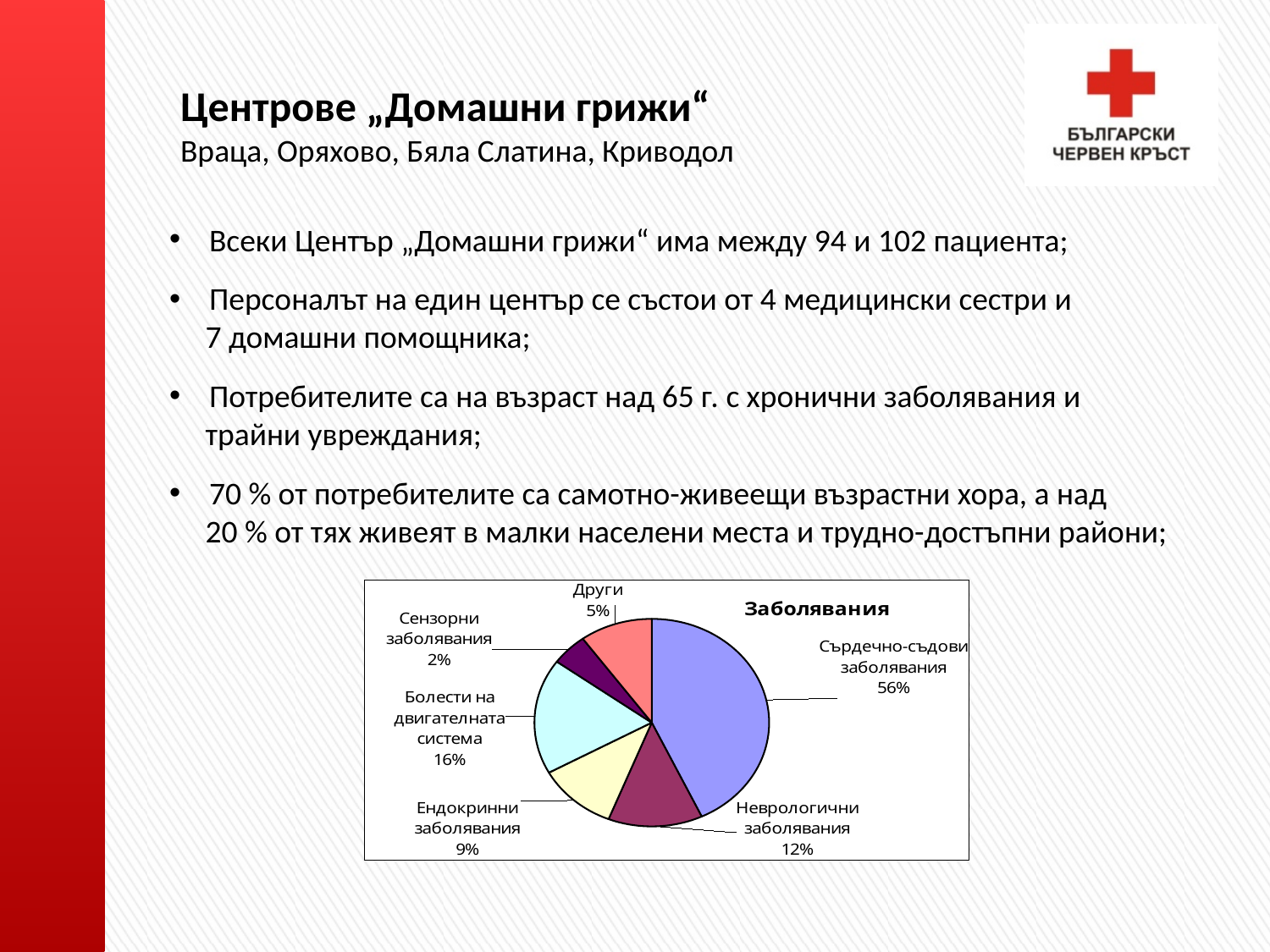
What share of the pie is Неврологични заболявания? 12% What share of the pie is Сензорни заболявания? 2% What share of the pie is Други? 5% What type of chart is shown on the slide? pie chart What is the difference between the shares of Болести на двигателната система and Неврологични заболявания? 4% Which category has the largest share of the pie? Сърдечно-съдови заболявания How many categories are shown in the pie chart? 6 Which category has the smallest share of the pie? Сензорни заболявания What is the title of the chart? Заболявания